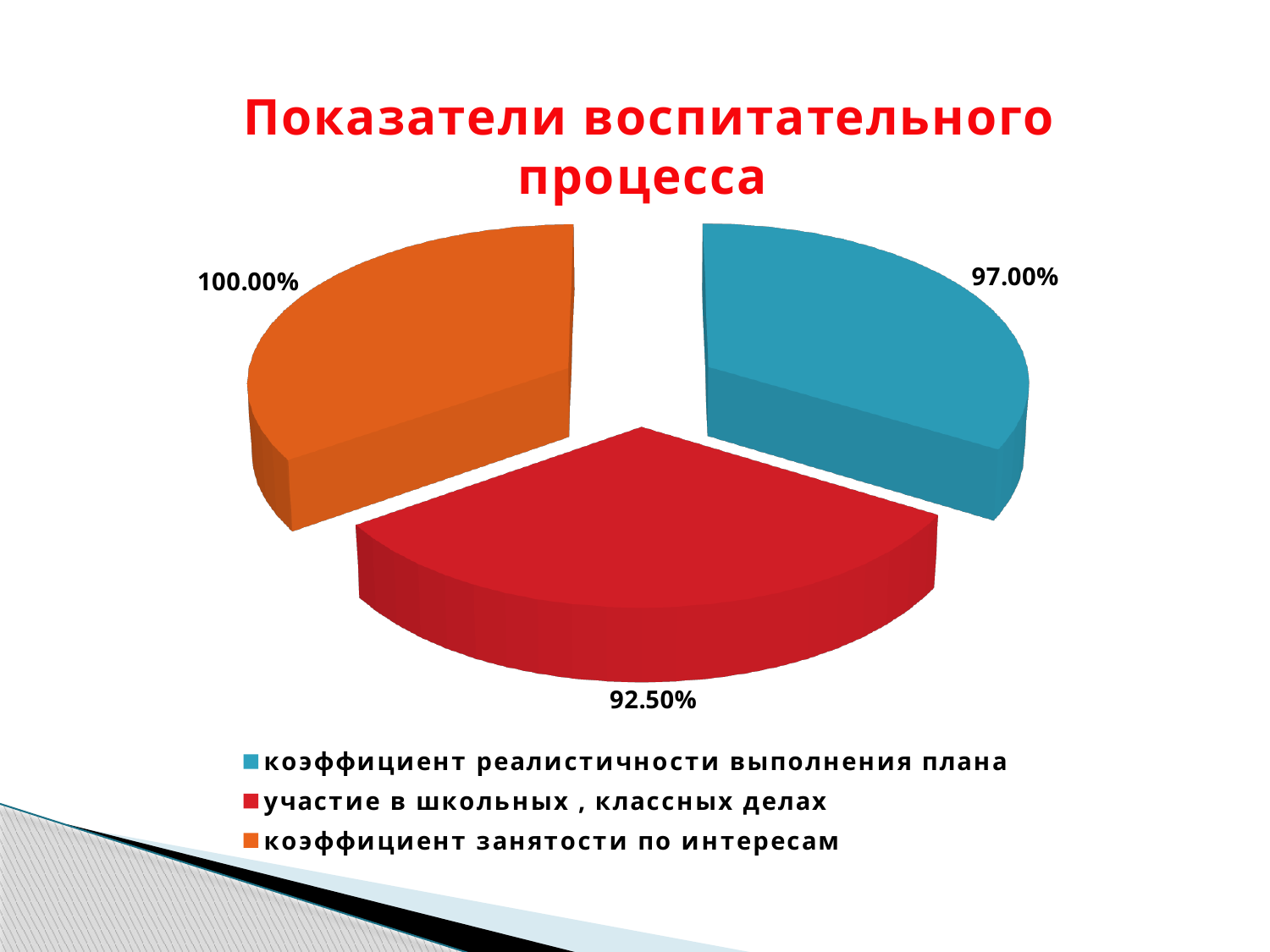
What is the difference between the values for «коэффициент реалистичности выполнения плана» and «участие в школьных, классных делах»? 4.50% What is the title of the chart? Показатели воспитательного процесса What is the value shown for «коэффициент занятости по интересам»? 100.00% What is the value shown for «участие в школьных, классных делах»? 92.50% Which colour represents «участие в школьных, классных делах» in the legend? Red Which is larger: the value for «коэффициент реалистичности выполнения плана» or for «участие в школьных, классных делах»? коэффициент реалистичности выполнения плана Which category has the lowest value? участие в школьных, классных делах What is the value shown for «коэффициент реалистичности выполнения плана»? 97.00% What kind of chart is shown on the slide? Pie chart What is the difference between the values for «коэффициент занятости по интересам» and «коэффициент реалистичности выполнения плана»? 3.00% How many slices does the pie chart have? 3 Which category has the highest value? коэффициент занятости по интересам